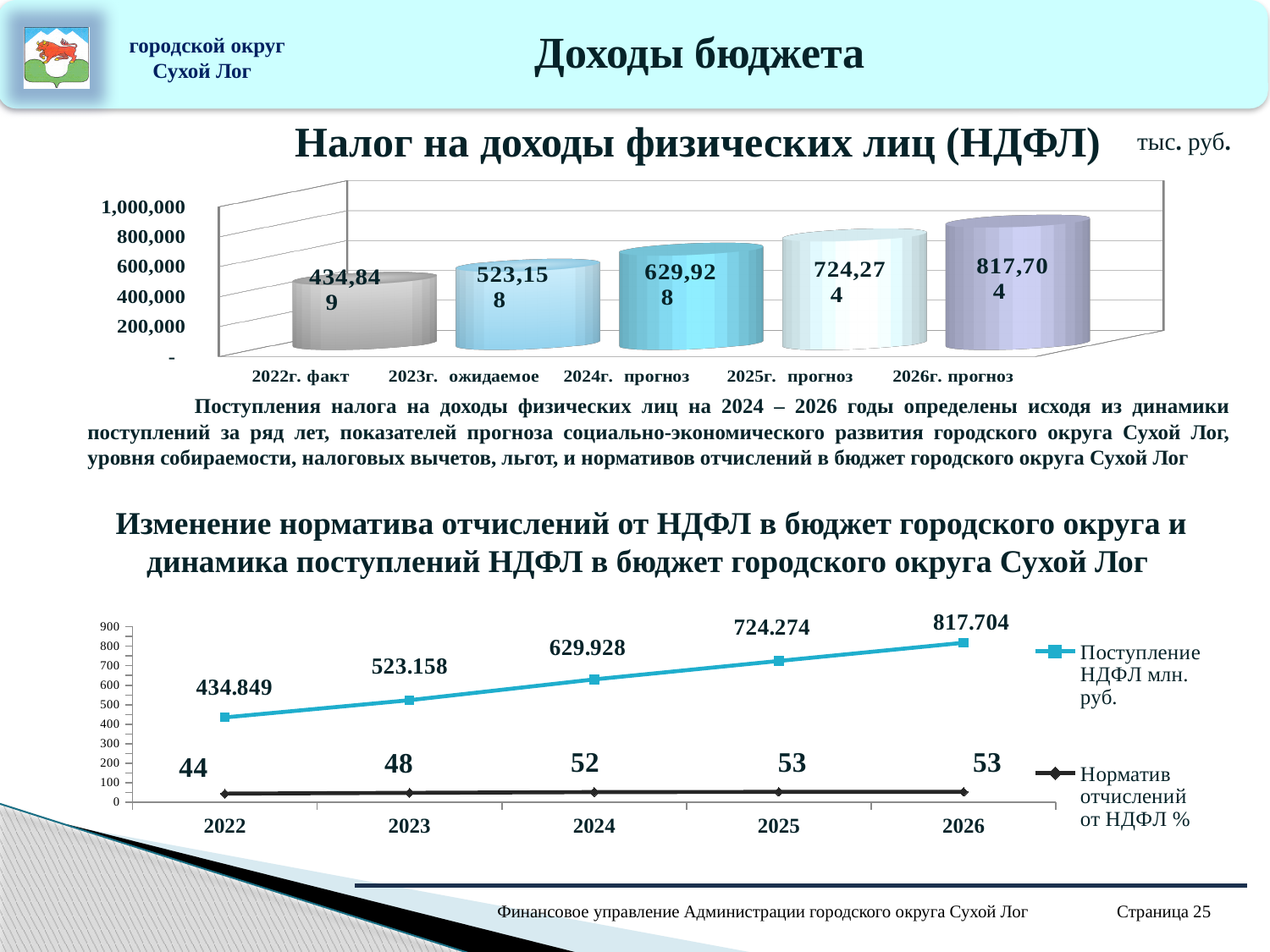
In the top chart (Налог на доходы физических лиц), how many bars are shown? 5 In the top chart (Налог на доходы физических лиц), what is the difference between the 2026г. прогноз and 2022г. факт values? 382,855 In the bottom chart, what is the value of Норматив отчислений от НДФЛ % for 2023? 48 In the bottom chart, how many series does the legend list? 2 In the top chart (Налог на доходы физических лиц), which category has the highest value? 2026г. прогноз In the top chart (Налог на доходы физических лиц), which category has the lowest value? 2022г. факт In the top chart (Налог на доходы физических лиц), what is the value for 2025г. прогноз? 724,274 In the top chart (Налог на доходы физических лиц), what is the value for 2022г. факт? 434,849 In the bottom chart, does the Поступление НДФЛ млн. руб. series rise or fall from 2022 to 2026? Rise In the bottom chart, which is larger: Норматив отчислений от НДФЛ % in 2022 or in 2024? 2024 What kind of chart is the top chart (Налог на доходы физических лиц)? Bar chart In the bottom chart, what is the value of Поступление НДФЛ млн. руб. for 2024? 629.928